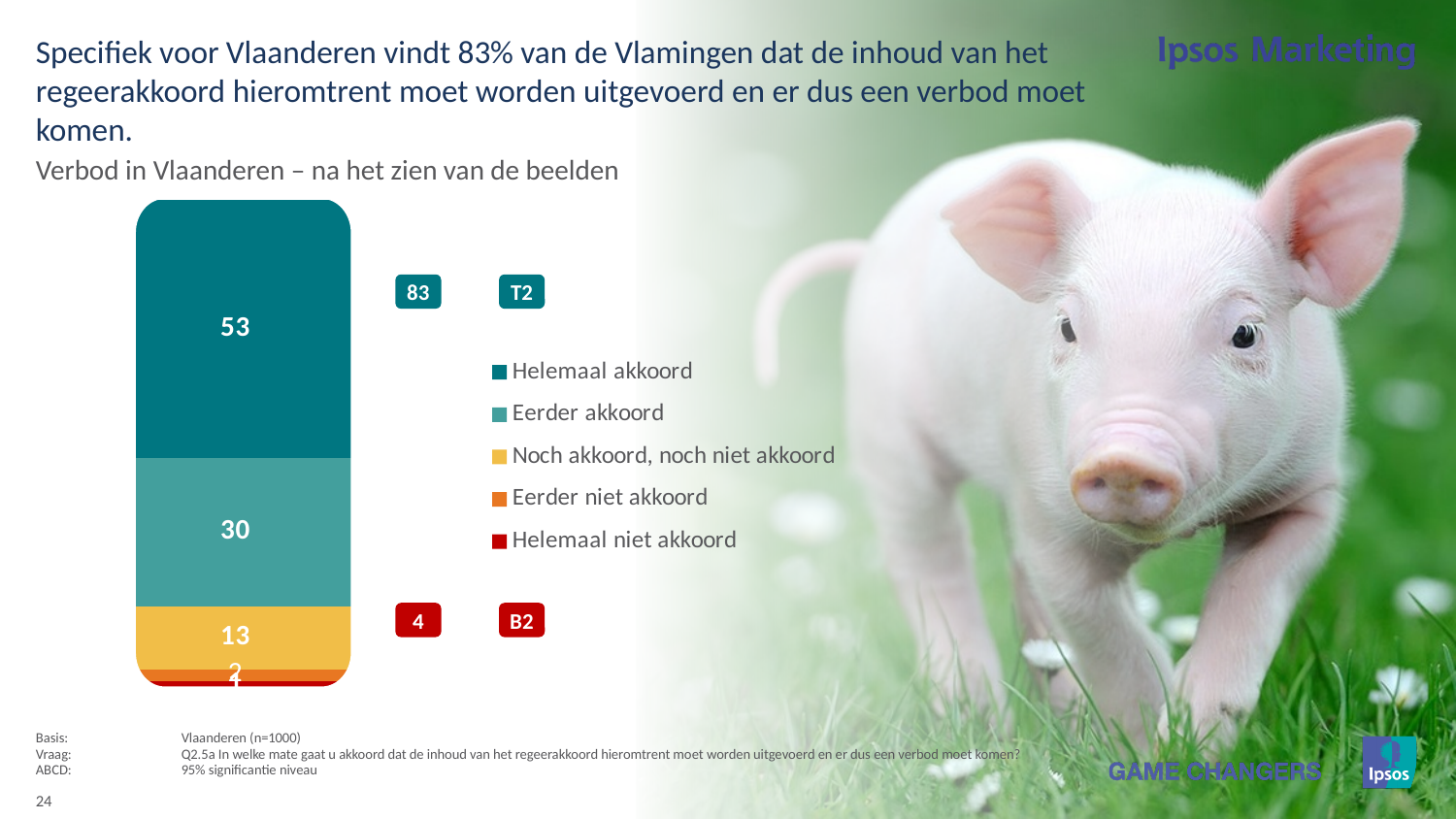
What is the combined total of the "Helemaal akkoord" and "Eerder akkoord" segments? 83 What kind of chart is shown on the slide? Stacked bar chart What is the subtitle printed directly above the chart? Verbod in Vlaanderen – na het zien van de beelden What is the value for "Eerder akkoord" in the stacked bar? 30 How many categories does the legend list? 5 What value is shown in the T2 box next to the bar? 83 What value is shown in the B2 box next to the bar? 4 Which legend category has the largest segment in the stacked bar? Helemaal akkoord What is the difference between the "Helemaal akkoord" and "Eerder akkoord" values? 23 What is the value for "Noch akkoord, noch niet akkoord" in the stacked bar? 13 What is the value for "Helemaal akkoord" in the stacked bar? 53 Which is larger: the value for "Eerder akkoord" or for "Noch akkoord, noch niet akkoord"? Eerder akkoord